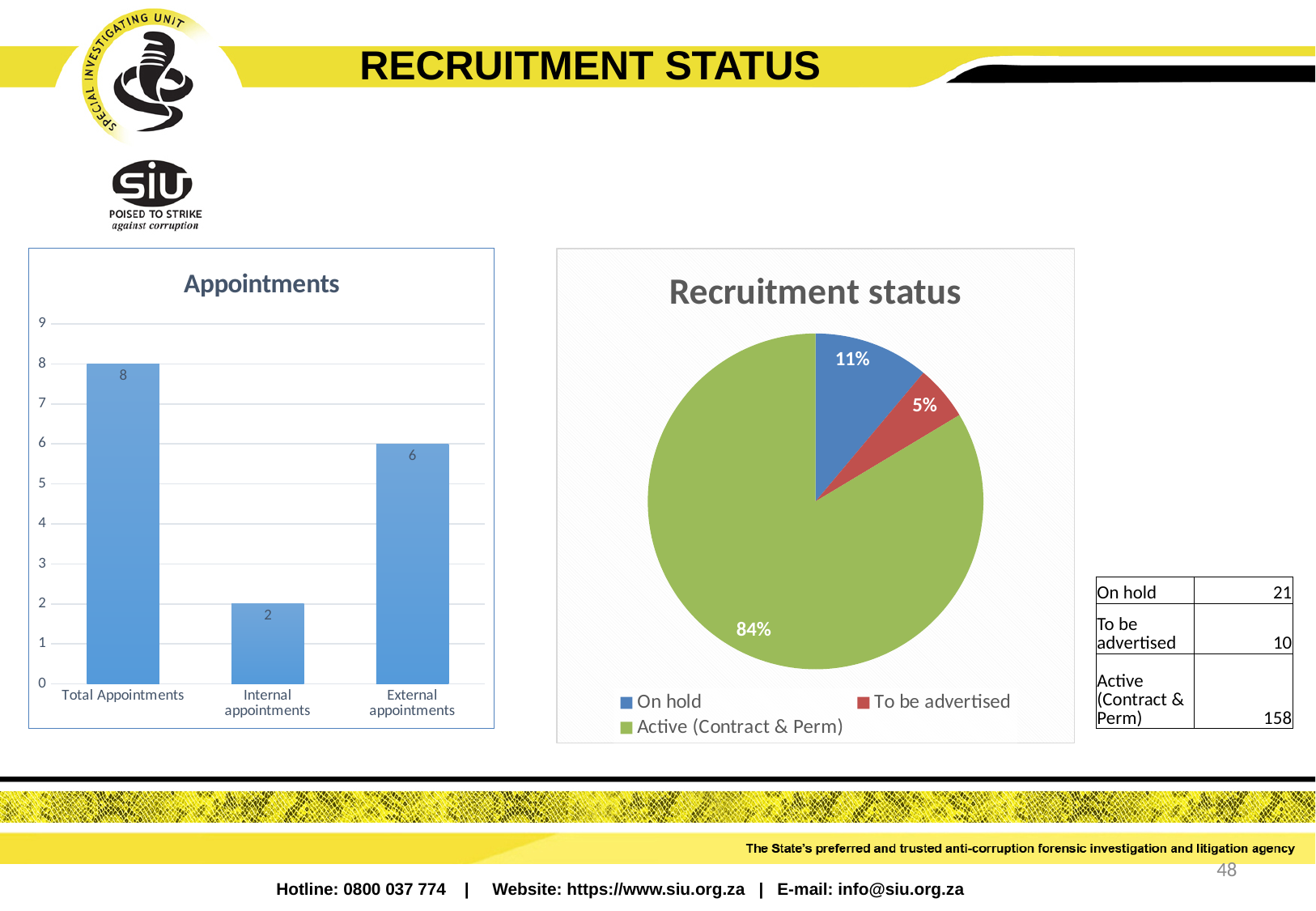
In the Appointments chart, how many categories are shown? 3 What kind of chart is the Recruitment status chart? pie chart In the Appointments chart, what is the value for External appointments? 6 In the Recruitment status chart, which slice is the largest? Active (Contract & Perm) In the Recruitment status chart, what share of the pie is To be advertised? 5% In the Recruitment status chart, what share of the pie is On hold? 11% What kind of chart is the Appointments chart? bar chart How many entries does the legend of the Recruitment status chart list? 3 In the Appointments chart, what is the value for Internal appointments? 2 In the Appointments chart, what is the value for Total Appointments? 8 In the Appointments chart, which category has the lowest value? Internal appointments In the Appointments chart, what is the difference between External appointments and Internal appointments? 4